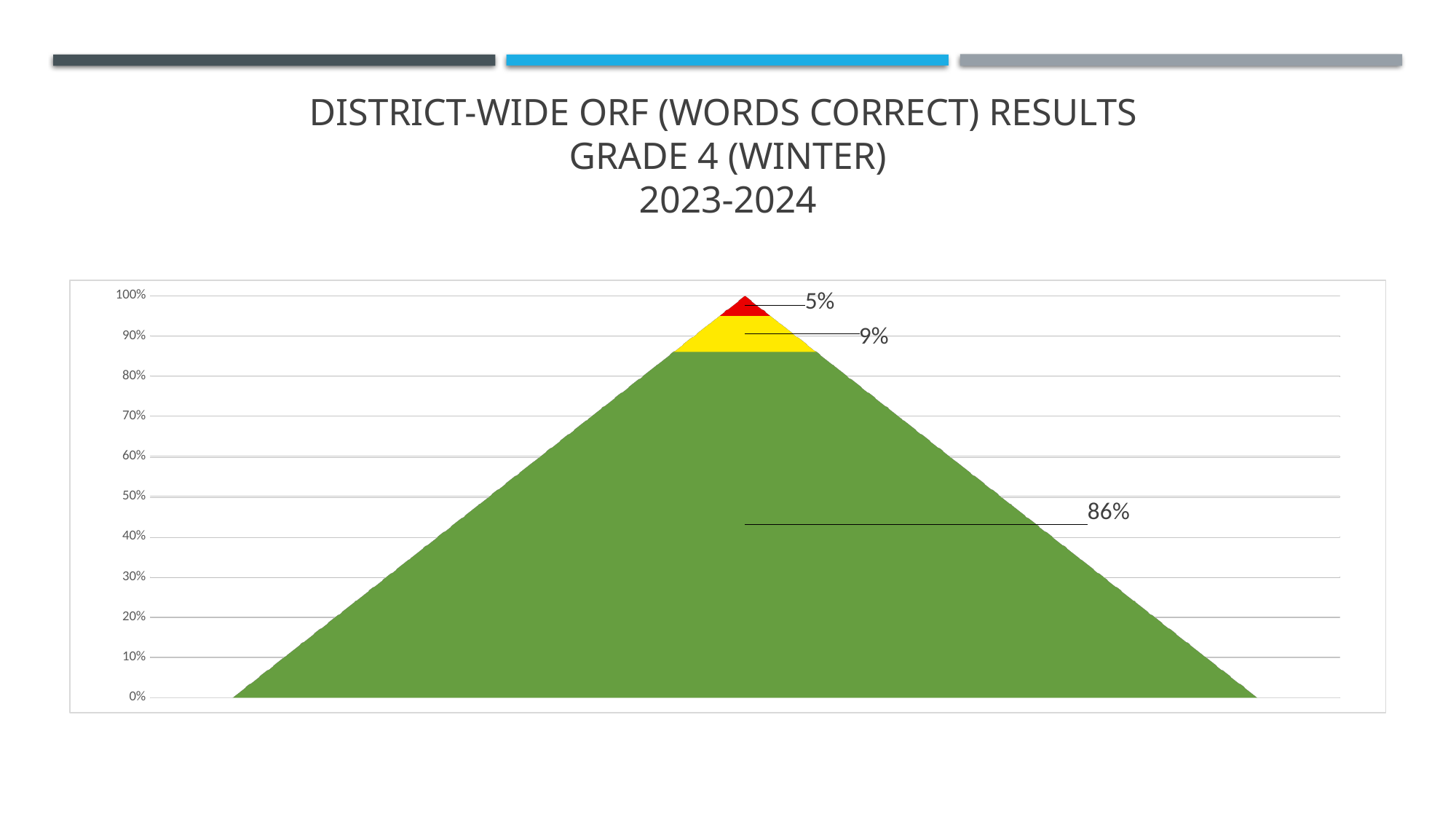
Which coloured segment of the pyramid has the smallest percentage? Red Which segment has a larger percentage, the yellow one or the red one? Yellow What is the difference between the yellow segment's percentage and the red segment's percentage? 4% What is the highest value shown on the vertical axis of the chart? 100% What percentage is shown for the green segment of the pyramid? 86% Which grade and season does the chart title say the results are for? Grade 4 (Winter) Which coloured segment of the pyramid has the largest percentage? Green What is the difference between the green segment's percentage and the yellow segment's percentage? 77% What percentage is shown for the yellow segment of the pyramid? 9% How many coloured segments make up the pyramid? 3 What is the total of the three segment percentages shown on the pyramid? 100% What percentage is shown for the red segment at the top of the pyramid? 5%